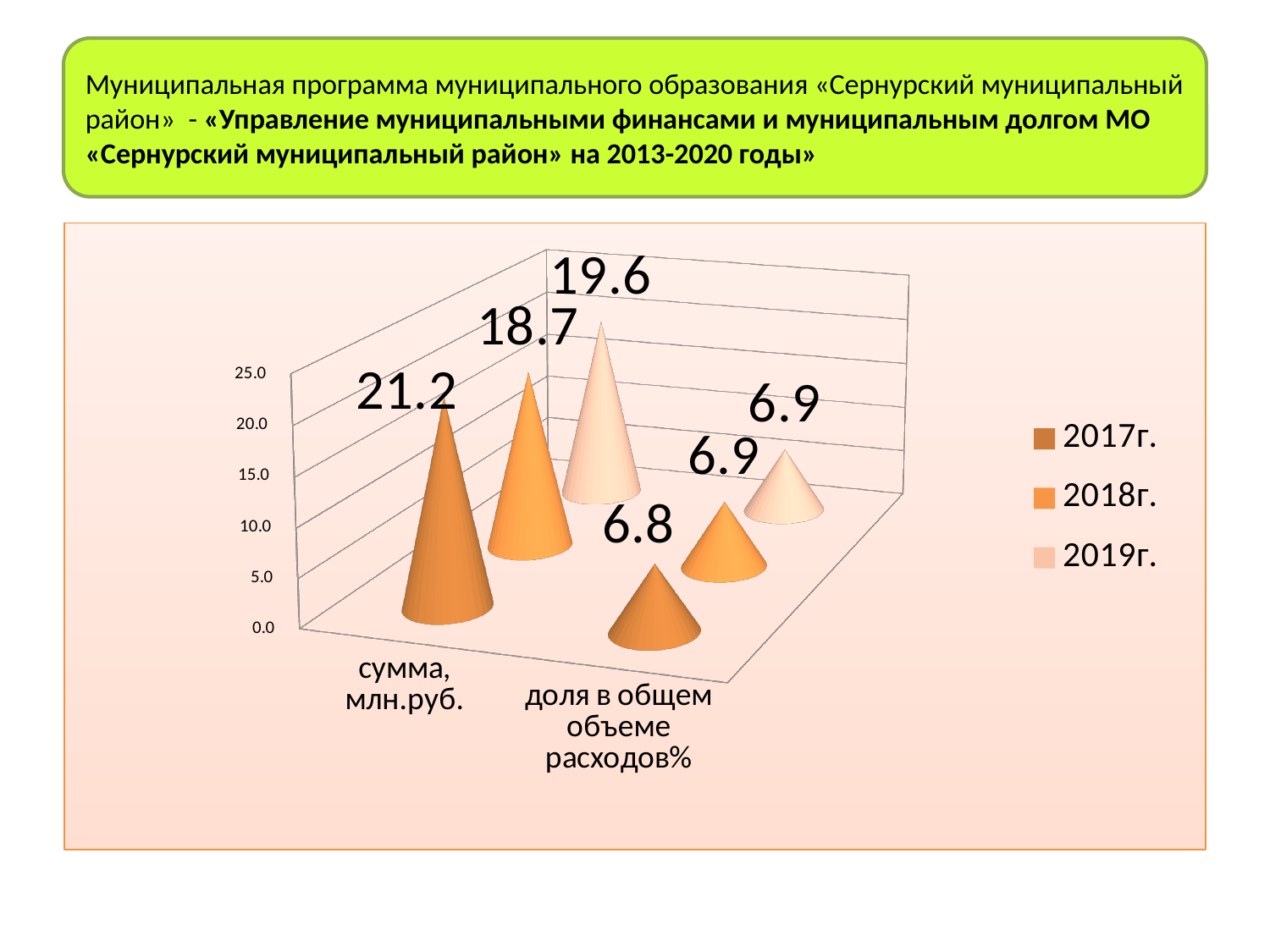
How many categories are shown on the x axis? 2 What kind of chart is shown on the slide? Bar chart What is the difference between the 2017г. and 2018г. values in the category «сумма, млн.руб.»? 2.5 Which year has the lowest value in the category «сумма, млн.руб.»? 2018г. How many series does the legend list? 3 What is the value for 2018г. in the category «сумма, млн.руб.»? 18.7 Which is larger in the category «сумма, млн.руб.»: the value for 2018г. or for 2019г.? 2019г. What is the value for 2017г. in the category «доля в общем объеме расходов%»? 6.8 What is the value for 2019г. in the category «доля в общем объеме расходов%»? 6.9 Which year has the highest value in the category «сумма, млн.руб.»? 2017г. What is the value for 2017г. in the category «сумма, млн.руб.»? 21.2 What is the value for 2019г. in the category «сумма, млн.руб.»? 19.6